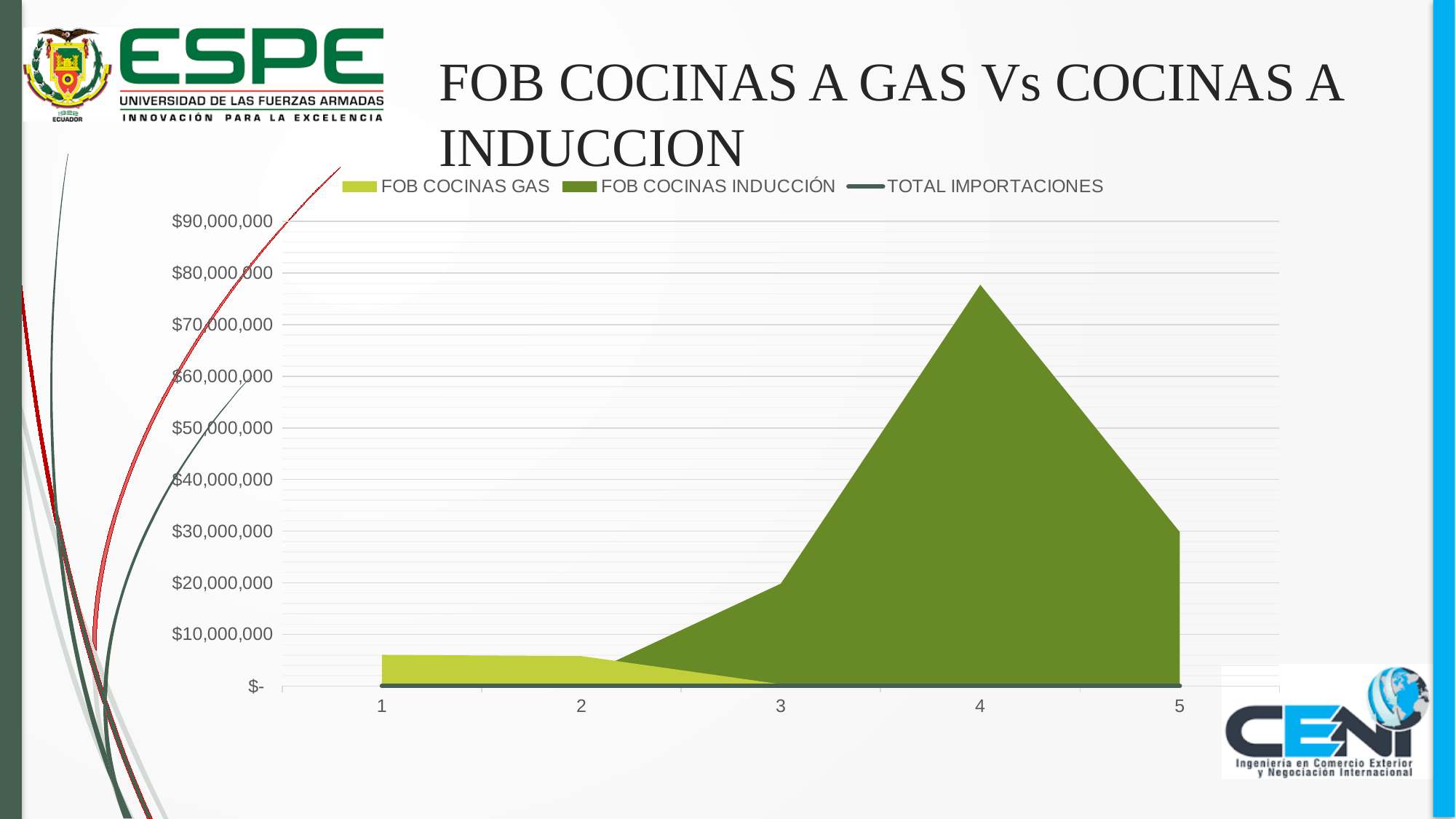
How many series does the legend list? 3 What is the title of the chart on the slide? FOB COCINAS A GAS Vs COCINAS A INDUCCION Which is larger: FOB COCINAS INDUCCIÓN at point 4 or FOB COCINAS GAS at point 1? FOB COCINAS INDUCCIÓN at point 4 What kind of chart is shown on the slide? combination area and line chart At which x-axis point does FOB COCINAS INDUCCIÓN reach its highest value? 4 Is the value of FOB COCINAS GAS at point 1 greater or less than $10,000,000? less How many points are plotted along the x axis? 5 Which legend entry is shown as a line rather than a filled area? TOTAL IMPORTACIONES Is the value of FOB COCINAS INDUCCIÓN at point 4 greater or less than $80,000,000? less Is the value of FOB COCINAS INDUCCIÓN at point 4 greater or less than $70,000,000? greater Does FOB COCINAS INDUCCIÓN rise or fall from point 3 to point 4? rise Does FOB COCINAS INDUCCIÓN rise or fall from point 4 to point 5? fall